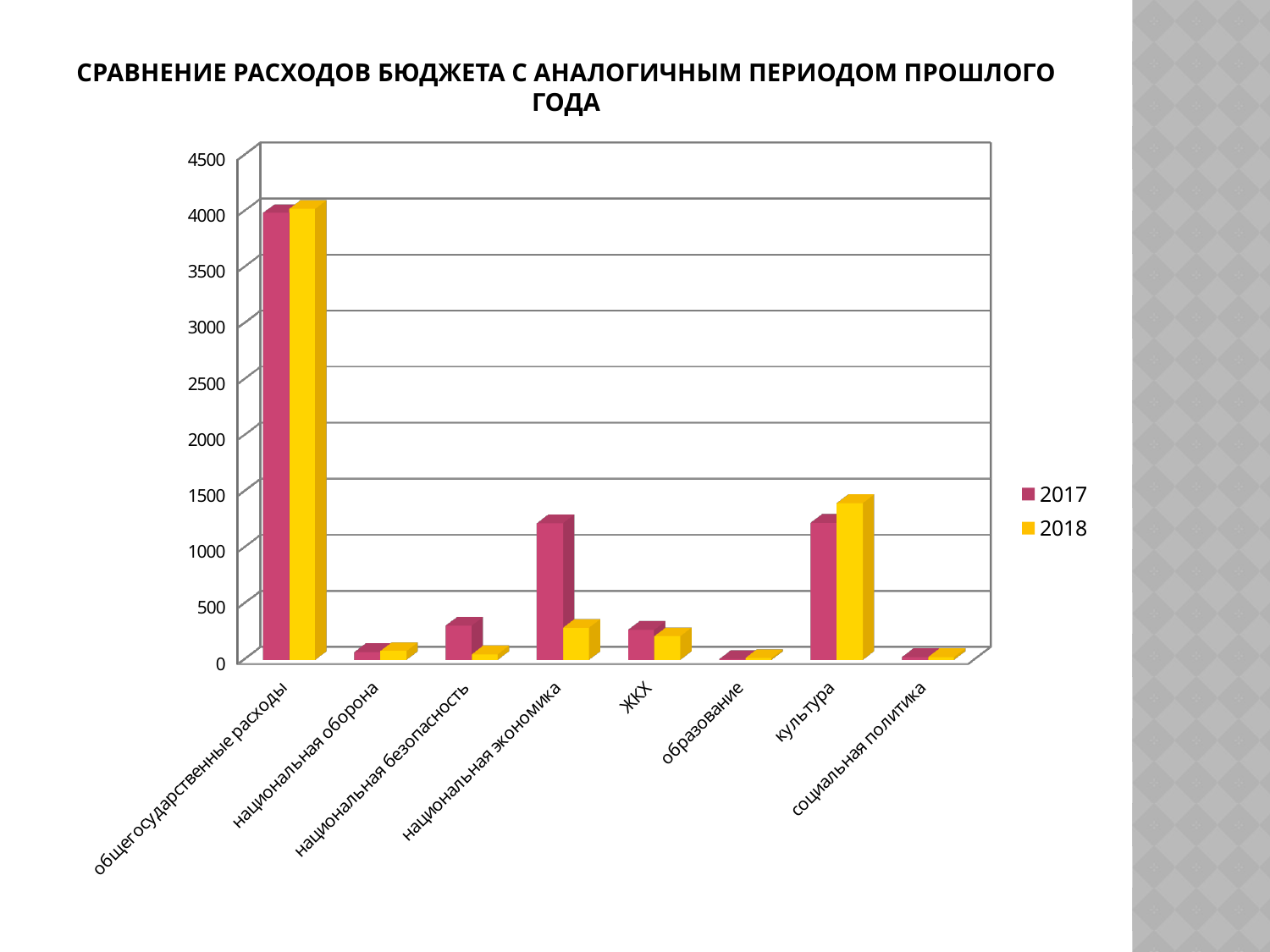
How many series does the legend list? 2 For национальная безопасность, which year has the larger value, 2017 or 2018? 2017 What kind of chart is shown on the slide? bar chart Which category has the highest value for 2018? общегосударственные расходы How many categories are shown on the x axis? 8 For национальная экономика, which year has the larger value, 2017 or 2018? 2017 Is the 2017 value for национальная экономика greater or less than 1000? greater Is the 2017 value for общегосударственные расходы greater or less than 3500? greater Which two series are listed in the legend? 2017 and 2018 Is the 2018 value for культура greater or less than 1000? greater Which category has the highest value for 2017? общегосударственные расходы